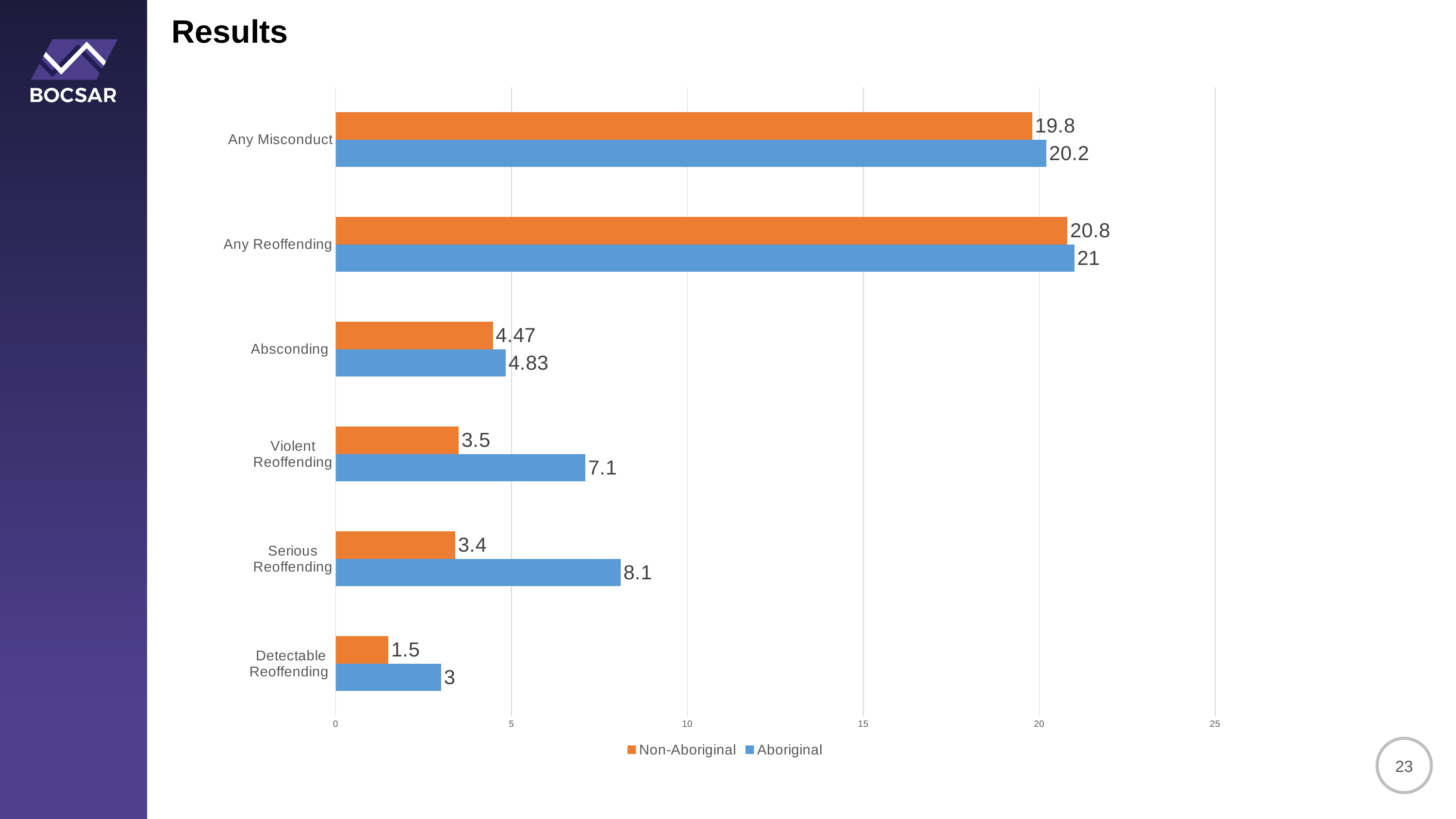
What is the Aboriginal value for Detectable Reoffending? 3 How many categories are shown on the chart? 6 Which category has the highest Aboriginal value? Any Reoffending What is the Aboriginal value for Serious Reoffending? 8.1 Which category has the lowest Non-Aboriginal value? Detectable Reoffending For Violent Reoffending, which series has the larger value, Aboriginal or Non-Aboriginal? Aboriginal Is the Non-Aboriginal value for Any Reoffending greater or less than 20? greater What kind of chart is shown on the slide? Bar chart What is the difference between the Aboriginal and Non-Aboriginal values for Serious Reoffending? 4.7 What is the difference between the Aboriginal and Non-Aboriginal values for Violent Reoffending? 3.6 What is the Non-Aboriginal value for Absconding? 4.47 How many series does the legend list? 2